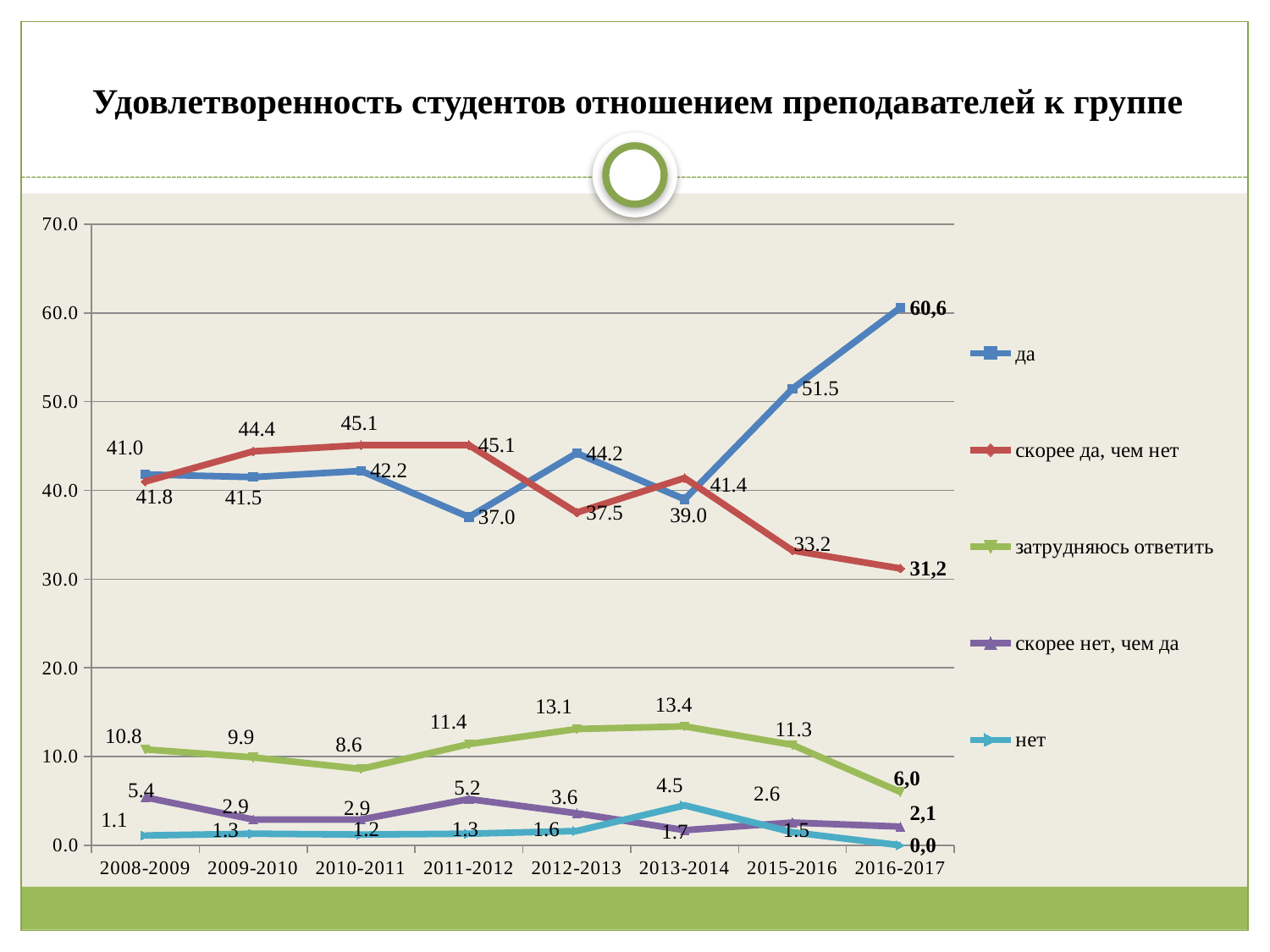
How many series does the legend list? 5 What is the value for "да" in 2016-2017? 60,6 In which year is the value for "затрудняюсь ответить" highest? 2013-2014 In which year is the value for "да" lowest? 2011-2012 How many academic years are shown on the x axis? 8 What kind of chart is shown on the slide? line chart What is the value for "скорее да, чем нет" in 2015-2016? 33.2 By how much did the value for "да" increase from 2015-2016 to 2016-2017? 9.1 In 2012-2013, which is larger: "да" or "скорее да, чем нет"? да What is the title of the chart? Удовлетворенность студентов отношением преподавателей к группе What is the value for "нет" in 2013-2014? 4.5 Does the value for "скорее да, чем нет" rise or fall from 2011-2012 to 2016-2017? fall